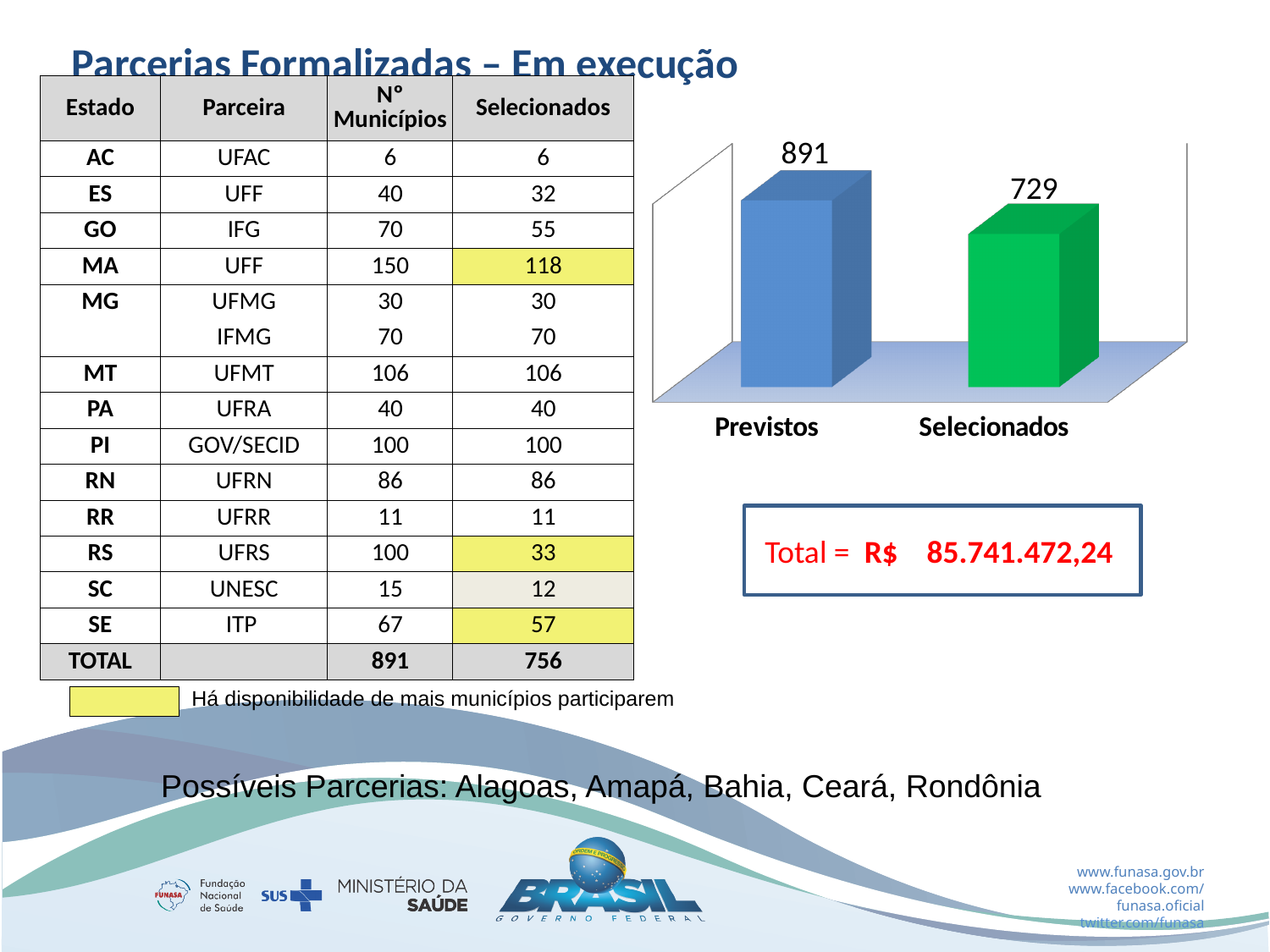
What value does the chart show for Previstos? 891 What is the difference between the Previstos and Selecionados values in the chart? 162 What colour is the Selecionados bar in the chart? green Is the value for Previstos larger or smaller than the value for Selecionados in the chart? larger Do the values in the chart rise or fall from Previstos to Selecionados? fall What kind of chart is shown on the slide? bar chart How many bars are plotted in the chart? 2 Which category in the chart has the lower value? Selecionados What colour is the Previstos bar in the chart? blue Which category in the chart has the higher value? Previstos What value does the chart show for Selecionados? 729